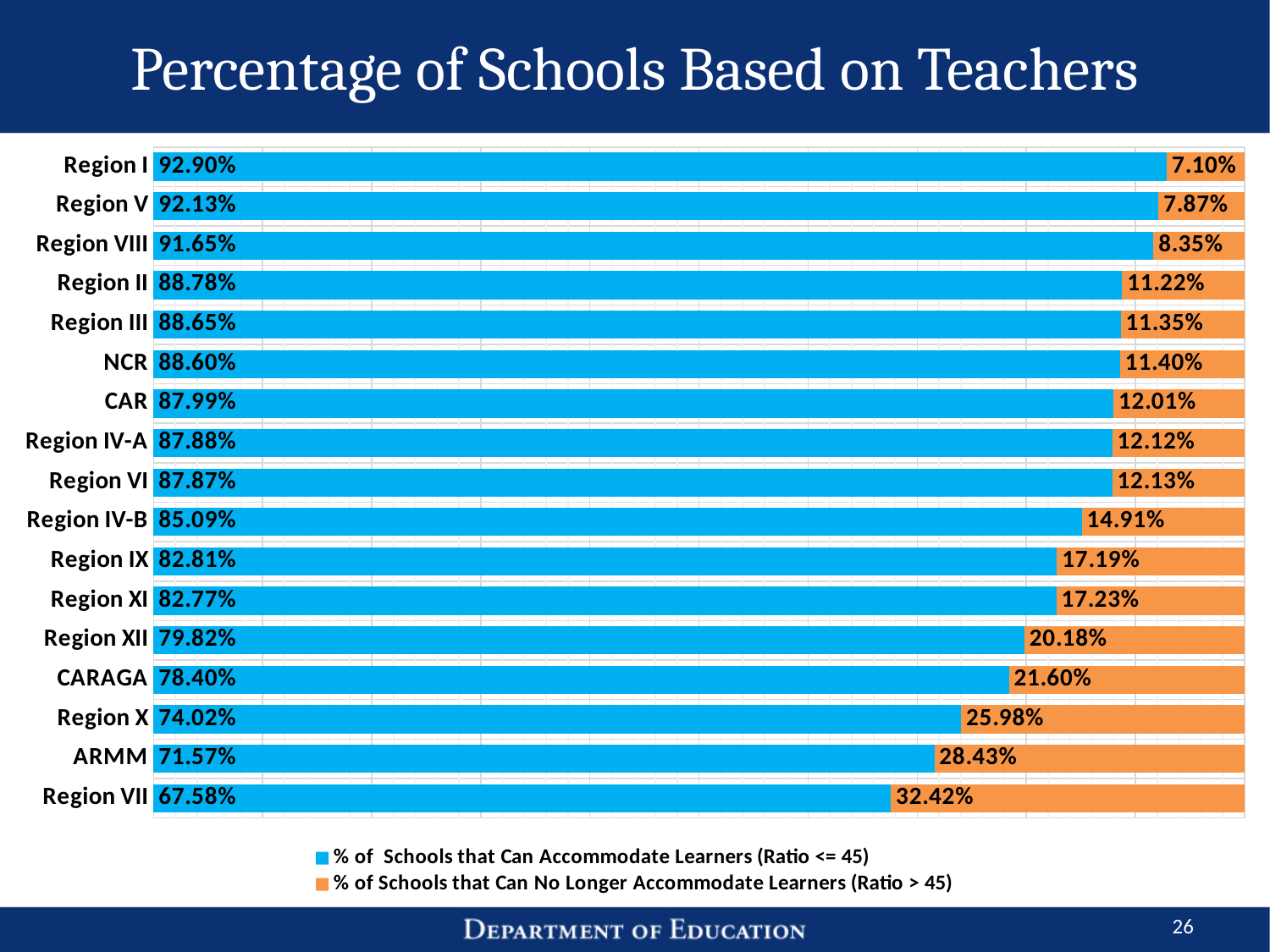
What percentage of schools in Region I can accommodate learners (Ratio <= 45)? 92.90% How many series does the legend list? 2 Which region has the highest percentage of schools that can accommodate learners (Ratio <= 45)? Region I Which has a larger percentage of schools that can no longer accommodate learners (Ratio > 45): ARMM or CARAGA? ARMM Which region has the highest percentage of schools that can no longer accommodate learners (Ratio > 45)? Region VII What percentage of schools in Region VII can no longer accommodate learners (Ratio > 45)? 32.42% How many regions are shown in the chart? 17 What is the value for NCR in the '% of Schools that Can Accommodate Learners (Ratio <= 45)' series? 88.60% What is the total of the stacked bar for Region X? 100.00% Which region has the lowest percentage of schools that can accommodate learners (Ratio <= 45)? Region VII What kind of chart is shown on the slide? Stacked bar chart What is the difference between the percentage of schools that can accommodate learners in Region I and in Region VII? 25.32%